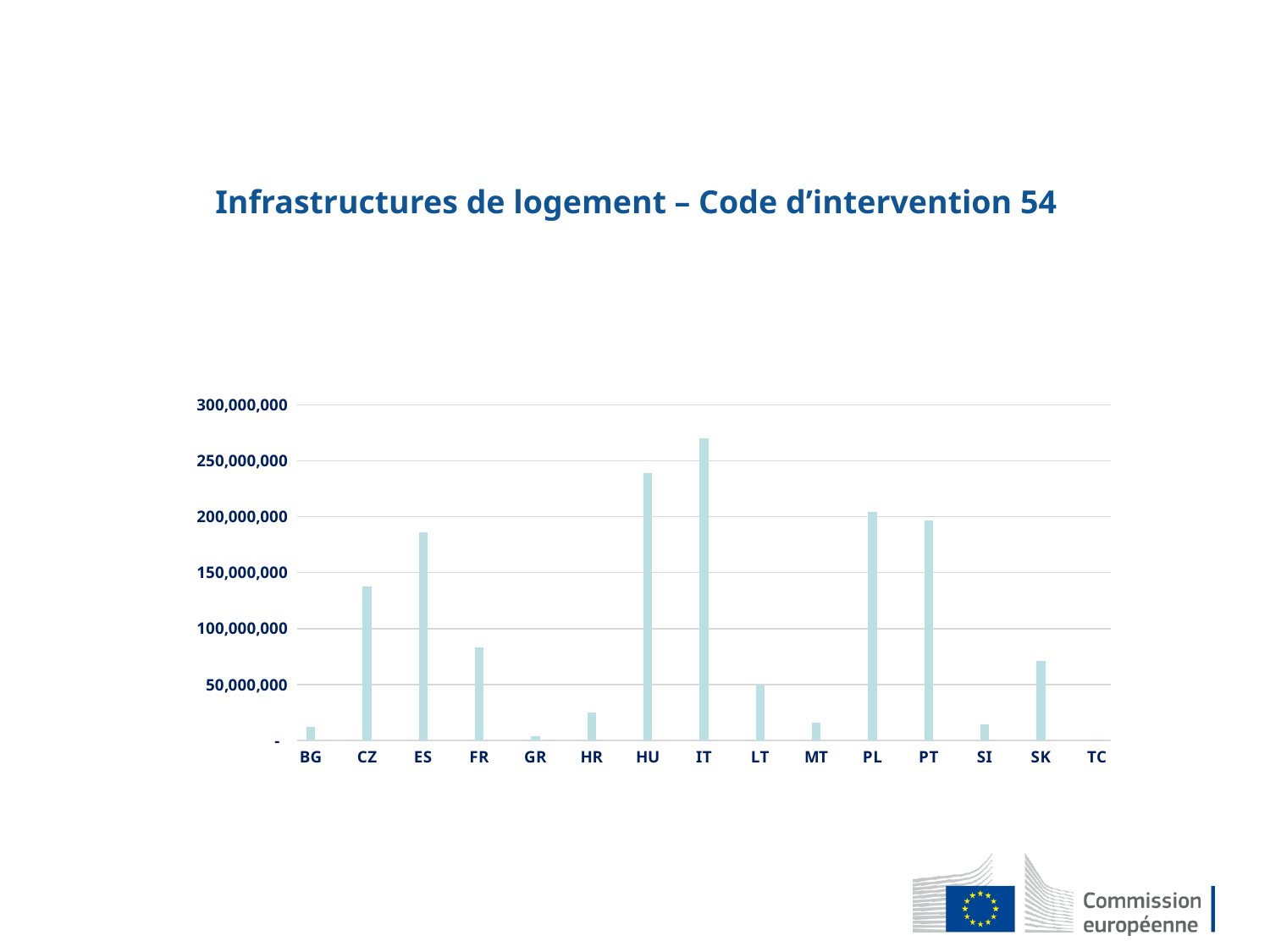
What kind of chart is shown on the slide? bar chart Is the value for CZ greater or less than 150,000,000? less Which category has the highest value in the chart? IT Is the value for SK greater or less than 50,000,000? greater Is the value for ES greater or less than 150,000,000? greater What is the title of the chart on the slide? Infrastructures de logement – Code d’intervention 54 How many categories are shown on the x axis of the chart? 15 Which has the larger value, HU or IT? IT Which has the larger value, CZ or ES? ES